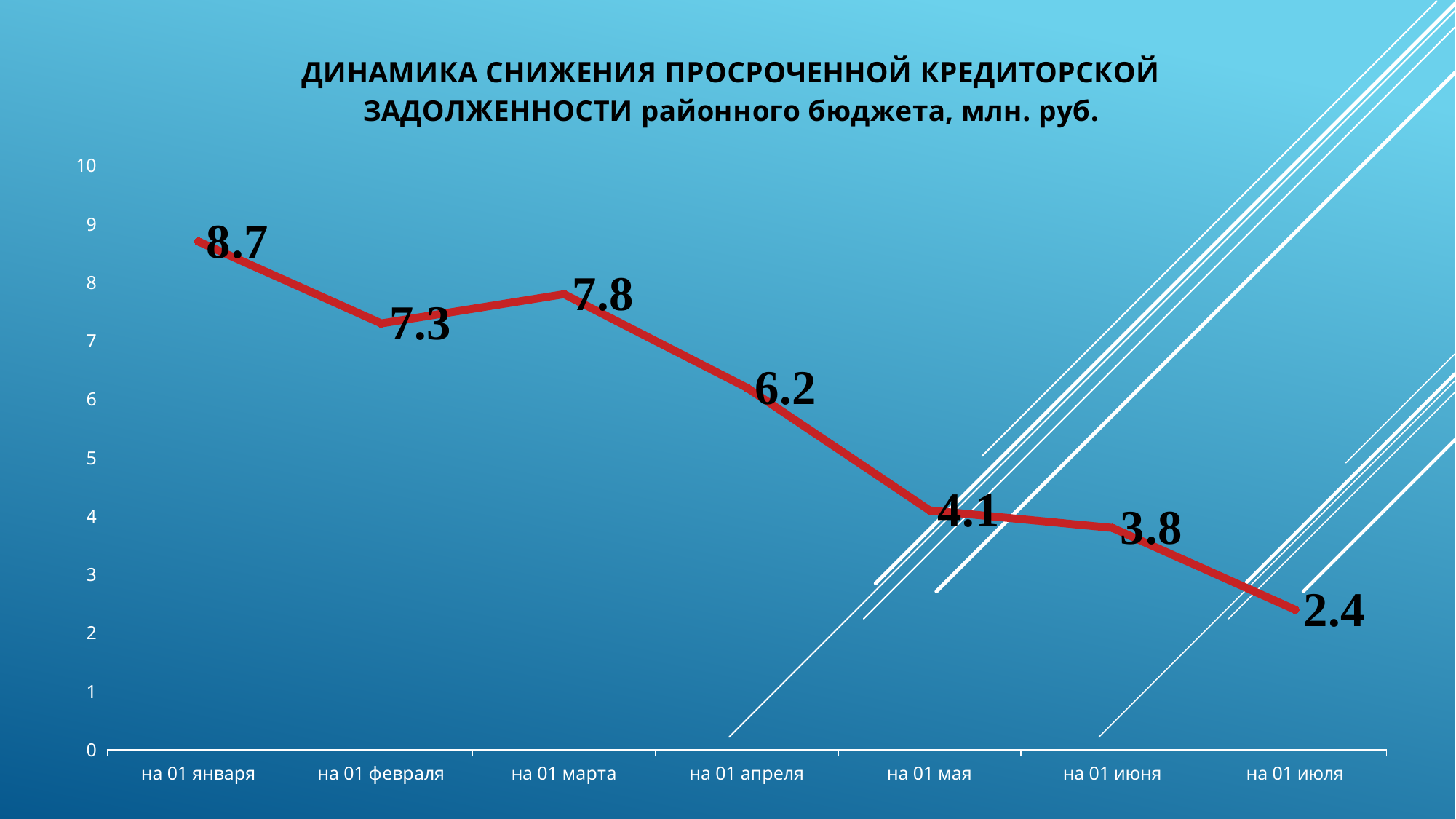
Which date has the lowest value? на 01 июля What is the difference between the values for на 01 января and на 01 июля? 6.3 What kind of chart is shown on the slide? line chart What is the value for на 01 января? 8.7 What is the maximum value shown on the vertical axis? 10 What is the value for на 01 июля? 2.4 What is the value for на 01 апреля? 6.2 How many data points are plotted on the chart? 7 What is the difference between the values for на 01 марта and на 01 апреля? 1.6 Which is larger, the value for на 01 февраля or the value for на 01 марта? на 01 марта Which date has the highest value? на 01 января Do the values generally rise or fall from на 01 января to на 01 июля? fall